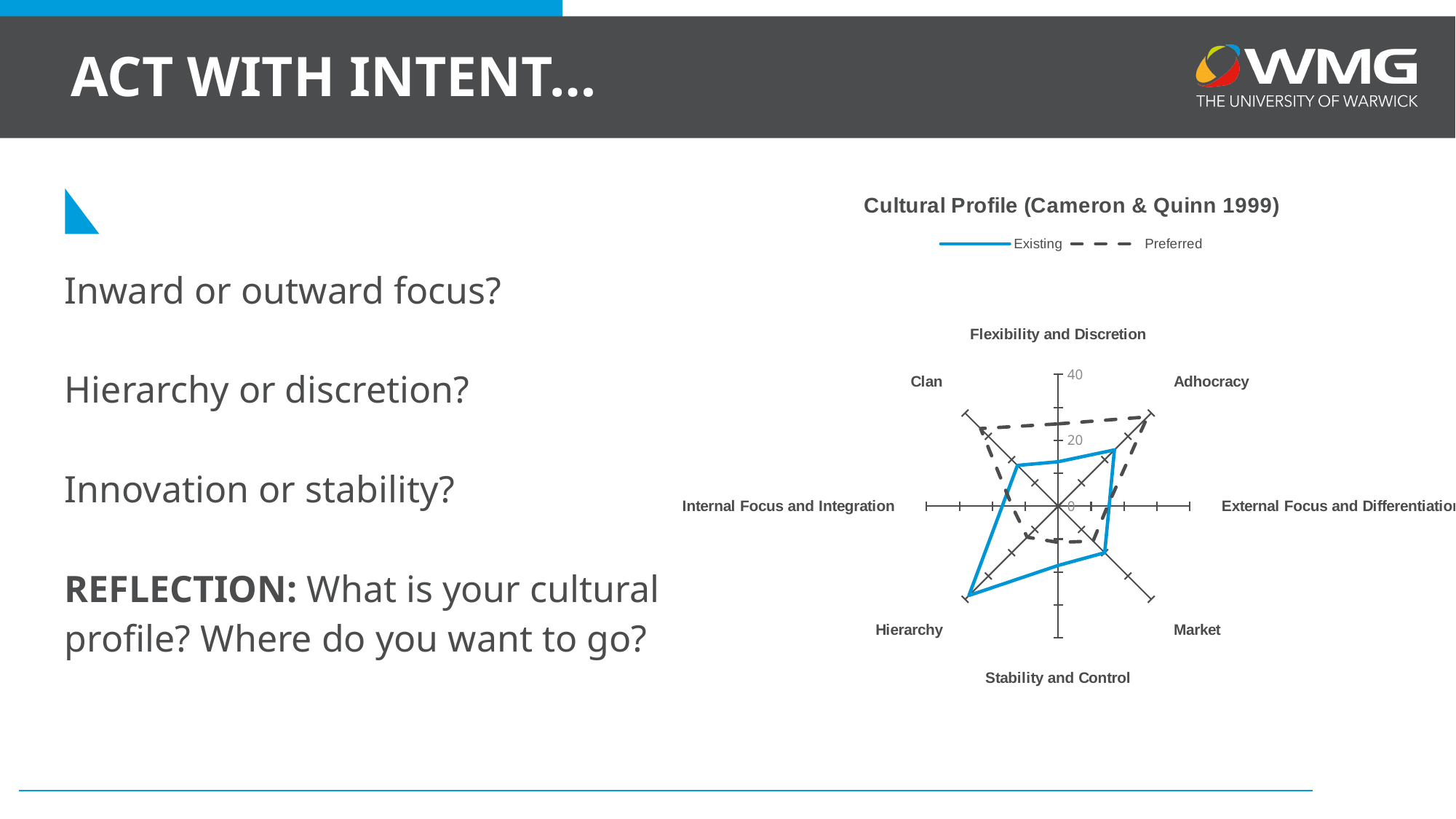
Is the Preferred value for Market greater or less than 20? less What kind of chart is shown on the slide? Radar chart Is the Preferred value for Clan greater or less than 20? greater For Hierarchy, which series has the larger value, Existing or Preferred? Existing For Clan, which series has the larger value, Existing or Preferred? Preferred Is the Existing value for Hierarchy greater or less than 20? greater Which two series are listed in the chart legend? Existing and Preferred For the Existing series, which culture type has the highest value? Hierarchy What is the title of the chart? Cultural Profile (Cameron & Quinn 1999) For Adhocracy, which series has the larger value, Existing or Preferred? Preferred How many series does the chart legend list? 2